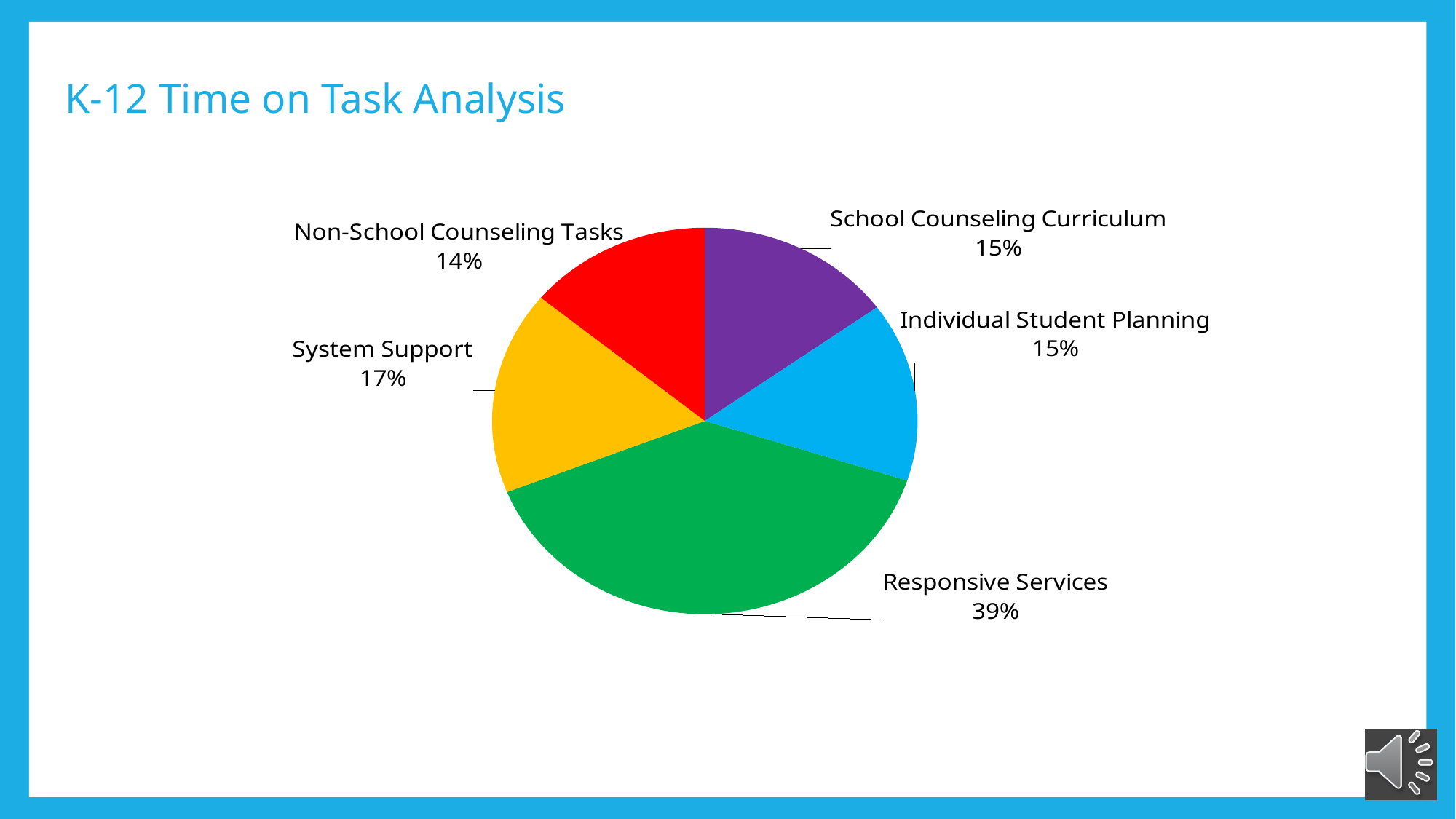
What is the title of the slide? K-12 Time on Task Analysis What percentage is shown for School Counseling Curriculum? 15% Which category has the smallest slice of the pie? Non-School Counseling Tasks What kind of chart is shown on the slide? Pie chart How many categories are shown in the pie chart? 5 What is the difference in percentage points between Responsive Services and System Support? 22 Which is larger, System Support or Individual Student Planning? System Support What percentage is shown for Non-School Counseling Tasks? 14% What share of the pie does Responsive Services take? 39% What percentage is shown for System Support? 17% What colour is the Responsive Services slice? Green Which category has the largest slice of the pie? Responsive Services